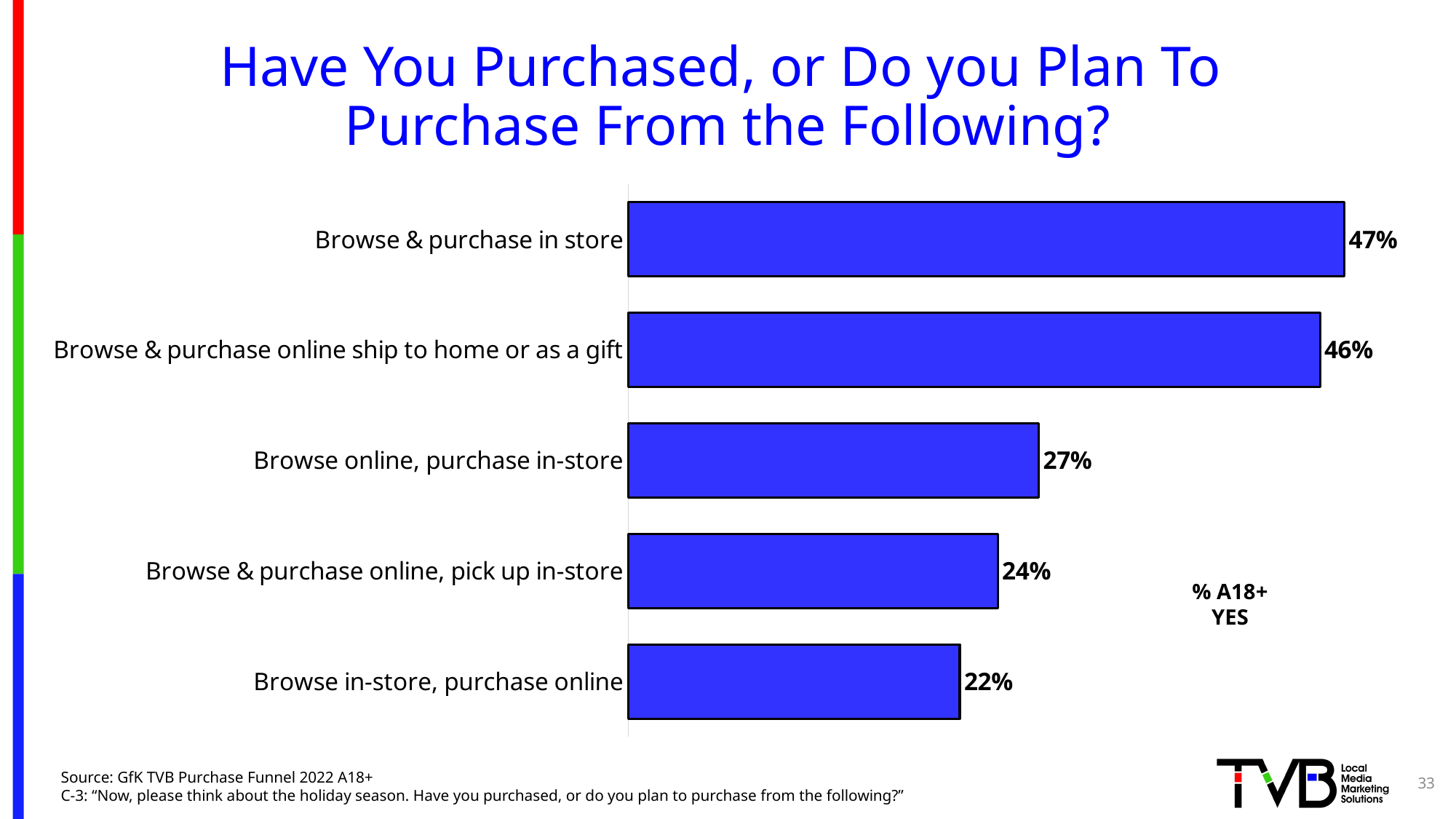
Which category has the lowest value? Browse in-store, purchase online What is the title of the chart on the slide? Have You Purchased, or Do you Plan To Purchase From the Following? What percentage of A18+ said yes to "Browse & purchase in store"? 47% What is the value for "Browse in-store, purchase online"? 22% What is the value for "Browse & purchase online ship to home or as a gift"? 46% What is the difference between "Browse & purchase in store" and "Browse in-store, purchase online"? 25% What is the value for "Browse online, purchase in-store"? 27% Which category has the highest value? Browse & purchase in store How many categories are shown in the chart? 5 What kind of chart is shown on the slide? Bar chart Which is larger: "Browse online, purchase in-store" or "Browse & purchase online, pick up in-store"? Browse online, purchase in-store What is the difference between "Browse online, purchase in-store" and "Browse & purchase online, pick up in-store"? 3%